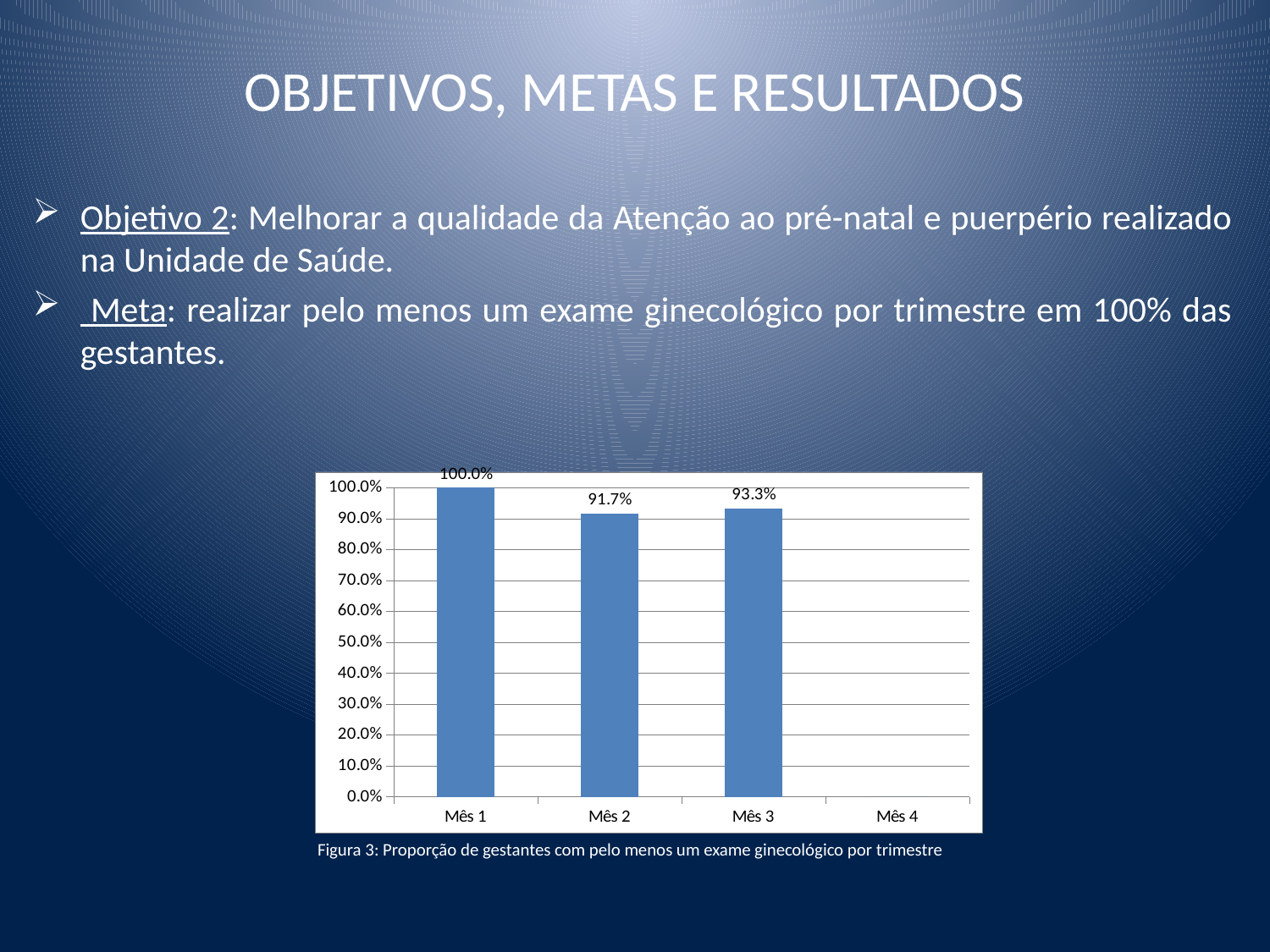
Is the value for Mês 2 greater or less than 90.0%? greater Does the value rise or fall from Mês 1 to Mês 2? fall What is the value for Mês 2? 91.7% What is the difference between the values for Mês 1 and Mês 2? 8.3% Among the bars plotted, which month has the lowest value? Mês 2 What is the difference between the values for Mês 3 and Mês 2? 1.6% What kind of chart is shown on the slide? bar chart Which is larger, the value for Mês 2 or the value for Mês 3? Mês 3 What is the value for Mês 3? 93.3% What is the value for Mês 1? 100.0% Which month has the highest value? Mês 1 How many month categories are shown on the x axis? 4